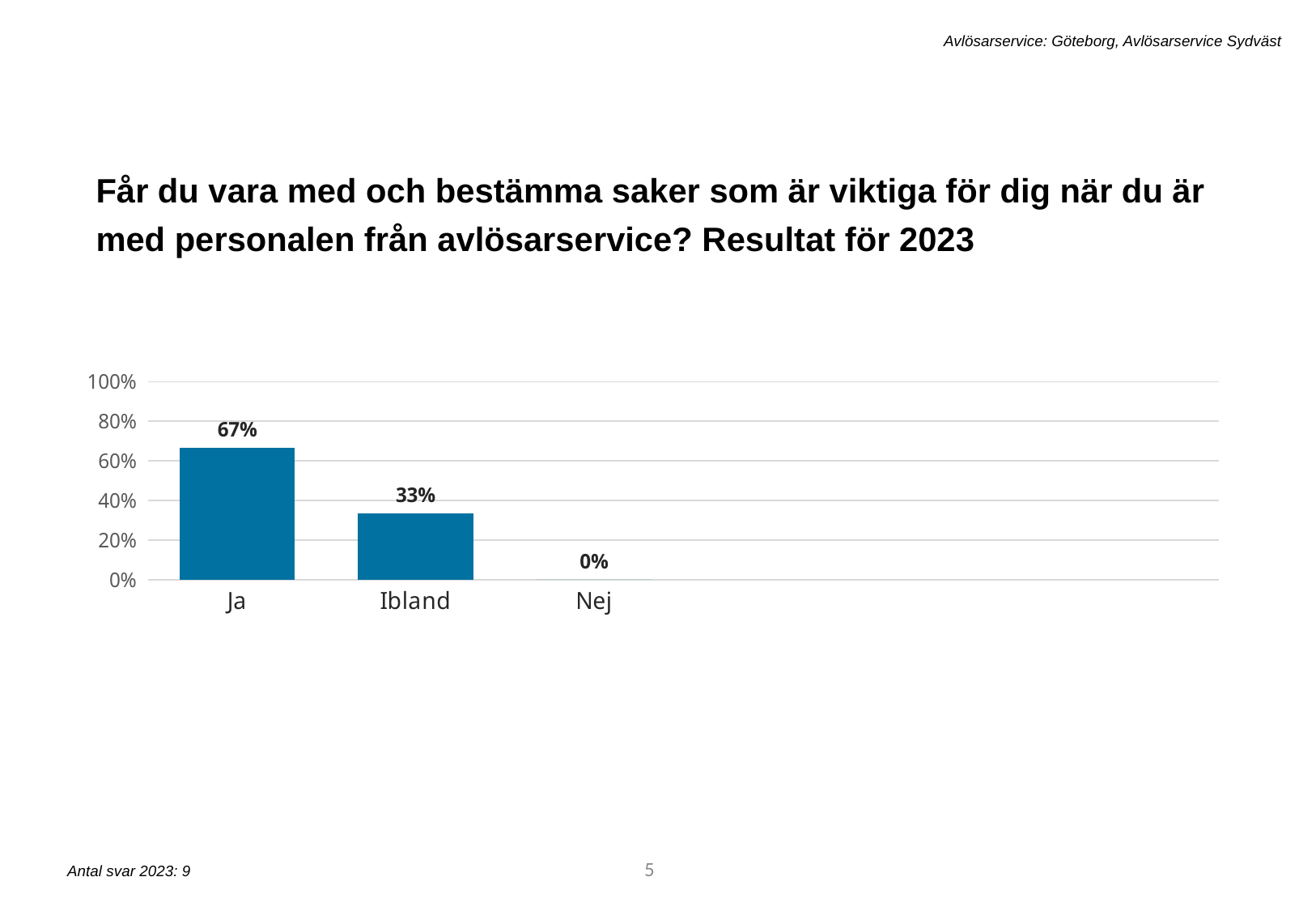
Which category has the highest value? Ja Do the values rise or fall from left to right along the x axis? fall Is the value for Ja greater or less than 60%? greater What is the value for Ja? 67% What is the value for Ibland? 33% How many categories are shown on the x axis? 3 What is the difference between the values for Ja and Ibland? 34% Which is larger, the value for Ibland or the value for Nej? Ibland Is the value for Ibland greater or less than 40%? less Which category has the lowest value? Nej What is the value for Nej? 0% What kind of chart is shown on the slide? bar chart